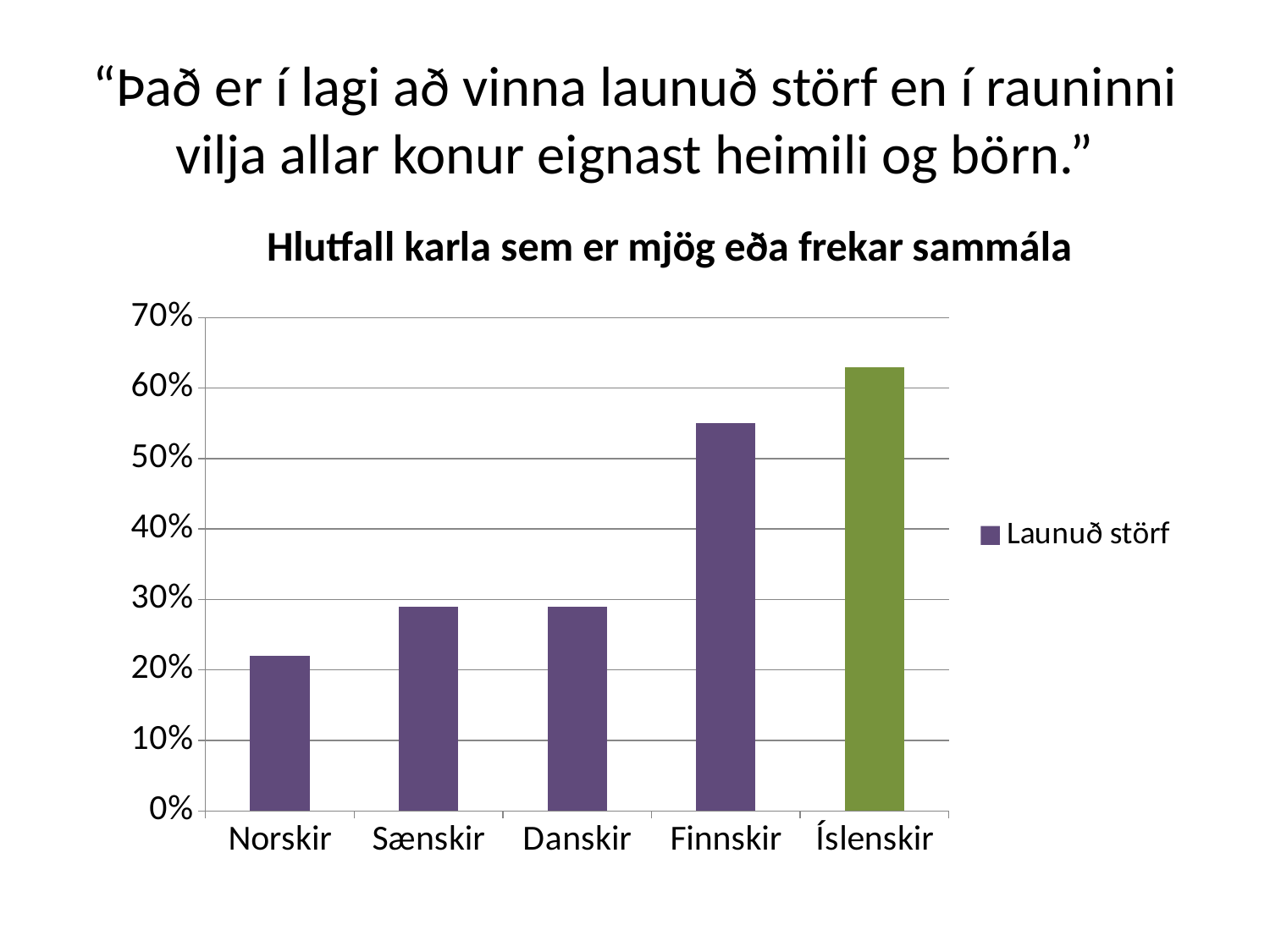
Is the value for Finnskir greater or less than 50%? greater What kind of chart is shown on the slide? bar chart Which category has the lowest value? Norskir What is the name of the series shown in the legend? Launuð störf What is the title of the chart? Hlutfall karla sem er mjög eða frekar sammála Which is larger, the value for Finnskir or the value for Sænskir? Finnskir How many series does the legend list? 1 How many categories are shown on the x axis of the chart? 5 Is the value for Íslenskir greater or less than 60%? greater Which category has the highest value? Íslenskir Is the value for Danskir greater or less than 40%? less